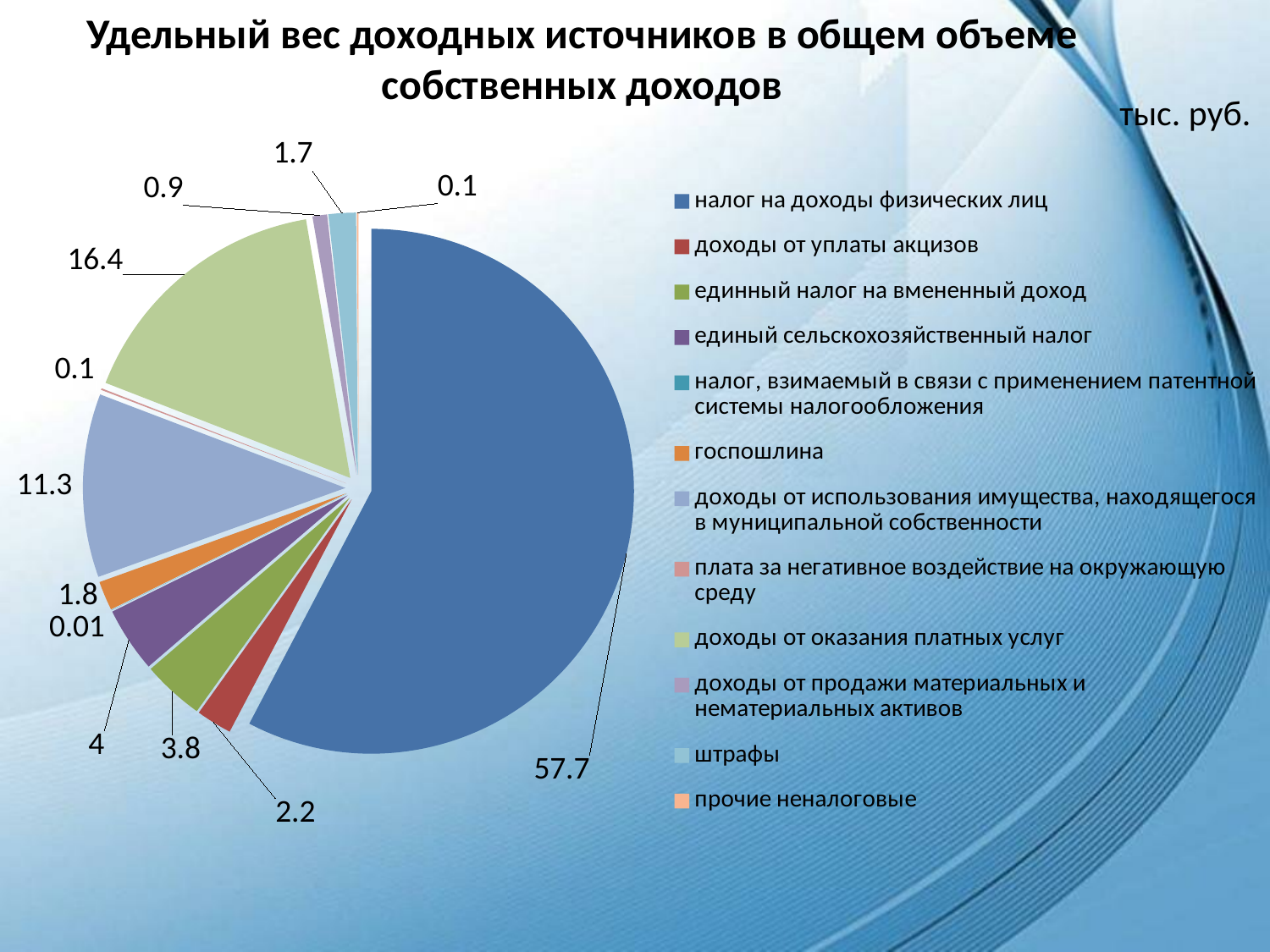
What unit is indicated in the top right corner of the slide? тыс. руб. What is the value shown for доходы от использования имущества, находящегося в муниципальной собственности? 11.3 What is the value shown for доходы от уплаты акцизов? 2.2 What kind of chart is shown on the slide? pie chart What is the value shown for госпошлина? 1.8 Which category has the largest slice of the pie? налог на доходы физических лиц How many categories does the legend of the pie chart list? 12 What is the value shown for доходы от оказания платных услуг? 16.4 What is the value shown for налог на доходы физических лиц? 57.7 What is the value shown for единый сельскохозяйственный налог? 4 What is the difference between the values for доходы от оказания платных услуг and доходы от использования имущества, находящегося в муниципальной собственности? 5.1 Which is larger, единый налог на вмененный доход or единый сельскохозяйственный налог? единый сельскохозяйственный налог